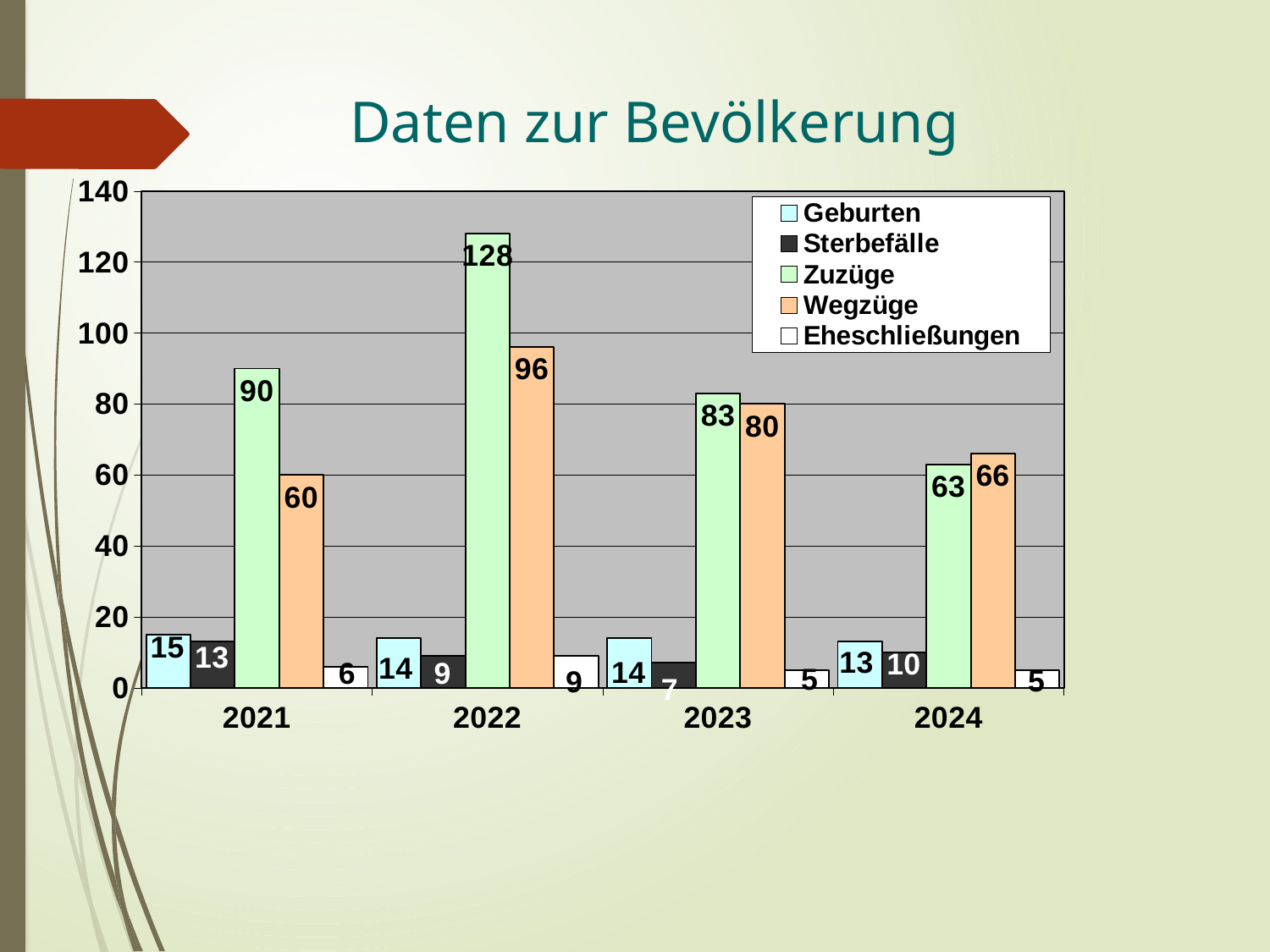
What is the title of the slide? Daten zur Bevölkerung Which is larger in 2024, Zuzüge or Wegzüge? Wegzüge In which year is the value for Zuzüge highest? 2022 What is the value for Eheschließungen in 2023? 5 What is the value for Wegzüge in 2021? 60 How many series does the legend list? 5 What is the value for Zuzüge in 2022? 128 In which year is the value for Sterbefälle lowest? 2023 What is the difference between Zuzüge and Wegzüge in 2021? 30 What is the value for Geburten in 2024? 13 What kind of chart is shown on the slide? Bar chart How many years are shown on the x axis? 4